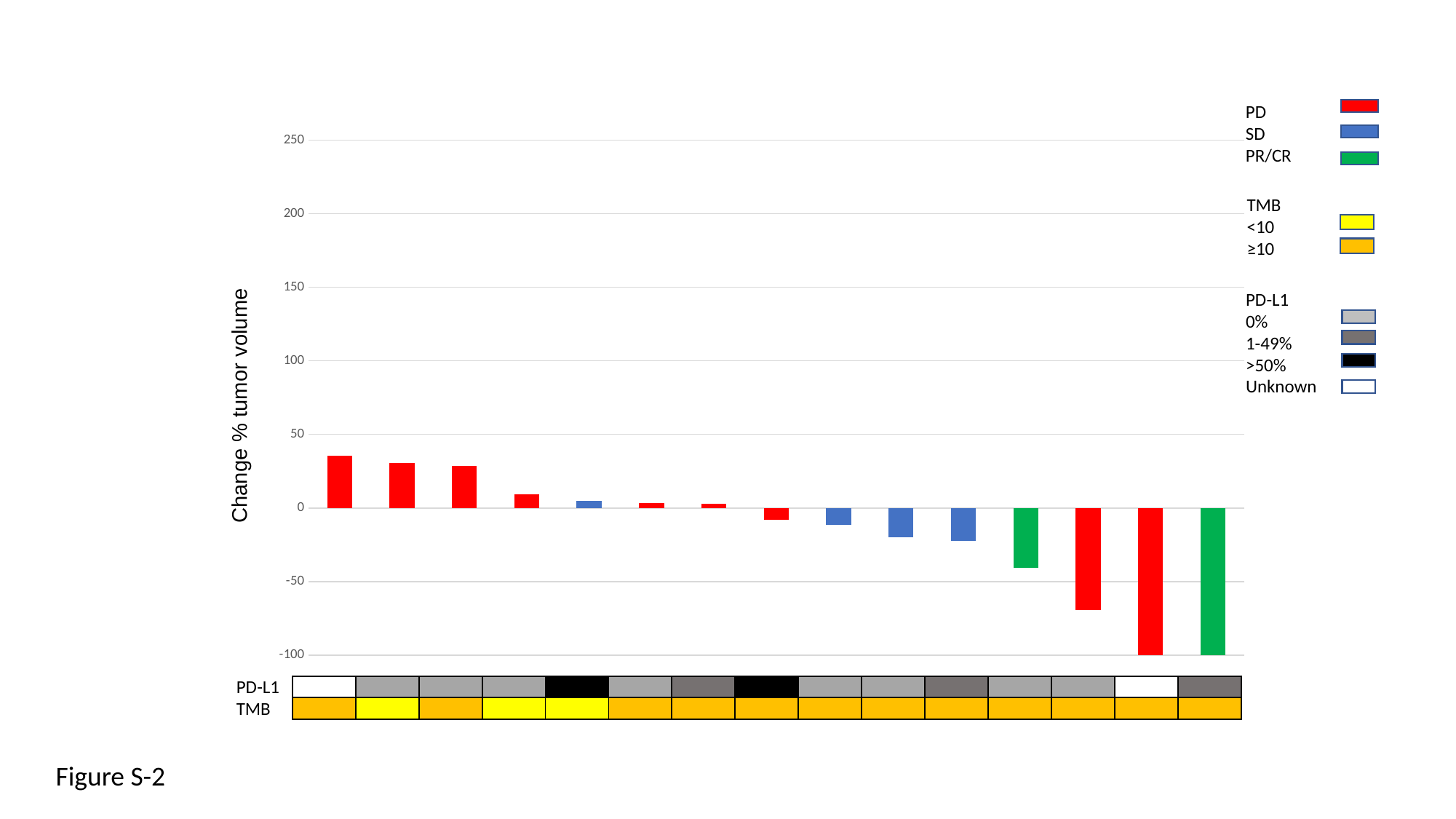
Is the value of the second bar from the right (red) greater or less than -50? less How many green (PR/CR) bars are in the chart? 2 Which bar has the highest value: the leftmost bar or the rightmost bar? the leftmost bar How many bars are plotted in the chart? 15 Which colour does the legend assign to PR/CR? green What kind of chart is shown on the slide? bar chart Do the bar values rise or fall from left to right along the x axis? fall Is the value of the leftmost bar greater or less than 50? less Is the value of the first green bar (fourth from the right) greater or less than -50? greater What is the label of the vertical axis? Change % tumor volume How many blue (SD) bars are in the chart? 4